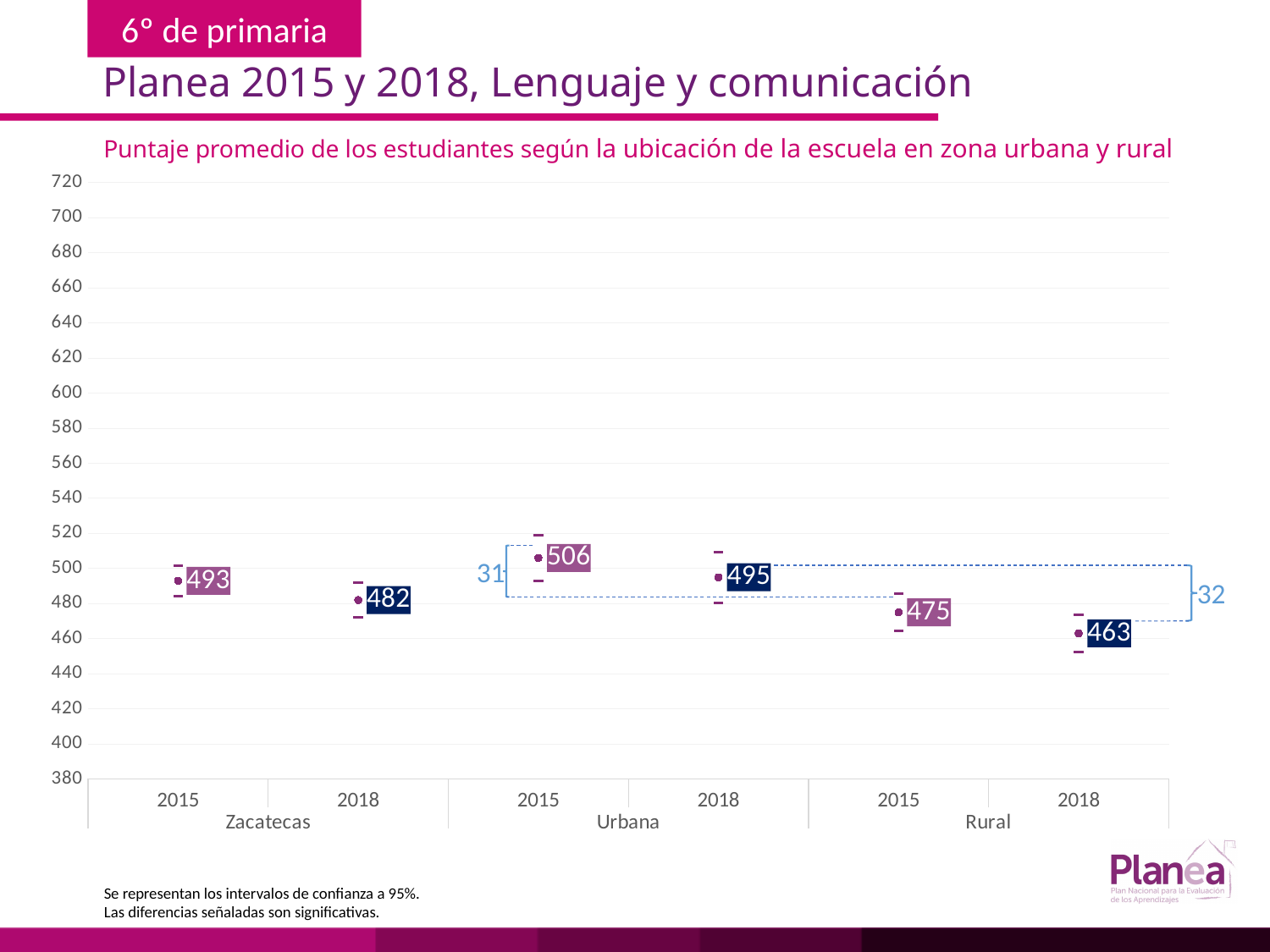
What is the difference between the Urbana and Rural average scores in 2015? 31 What is the subtitle of the chart? Puntaje promedio de los estudiantes según la ubicación de la escuela en zona urbana y rural What is the average score for Rural schools in 2018? 463 Which group and year has the lowest average score? Rural 2018 What is the average score for Zacatecas in 2018? 482 What is the difference between the Urbana and Rural average scores in 2018? 32 What is the average score for Zacatecas in 2015? 493 What is the average score for Urbana schools in 2015? 506 Which group and year has the highest average score? Urbana 2015 Which is larger, the Zacatecas score in 2015 or the Zacatecas score in 2018? Zacatecas 2015 Do the scores rise or fall from 2015 to 2018 for each group? fall How many data points are plotted on the chart? 6